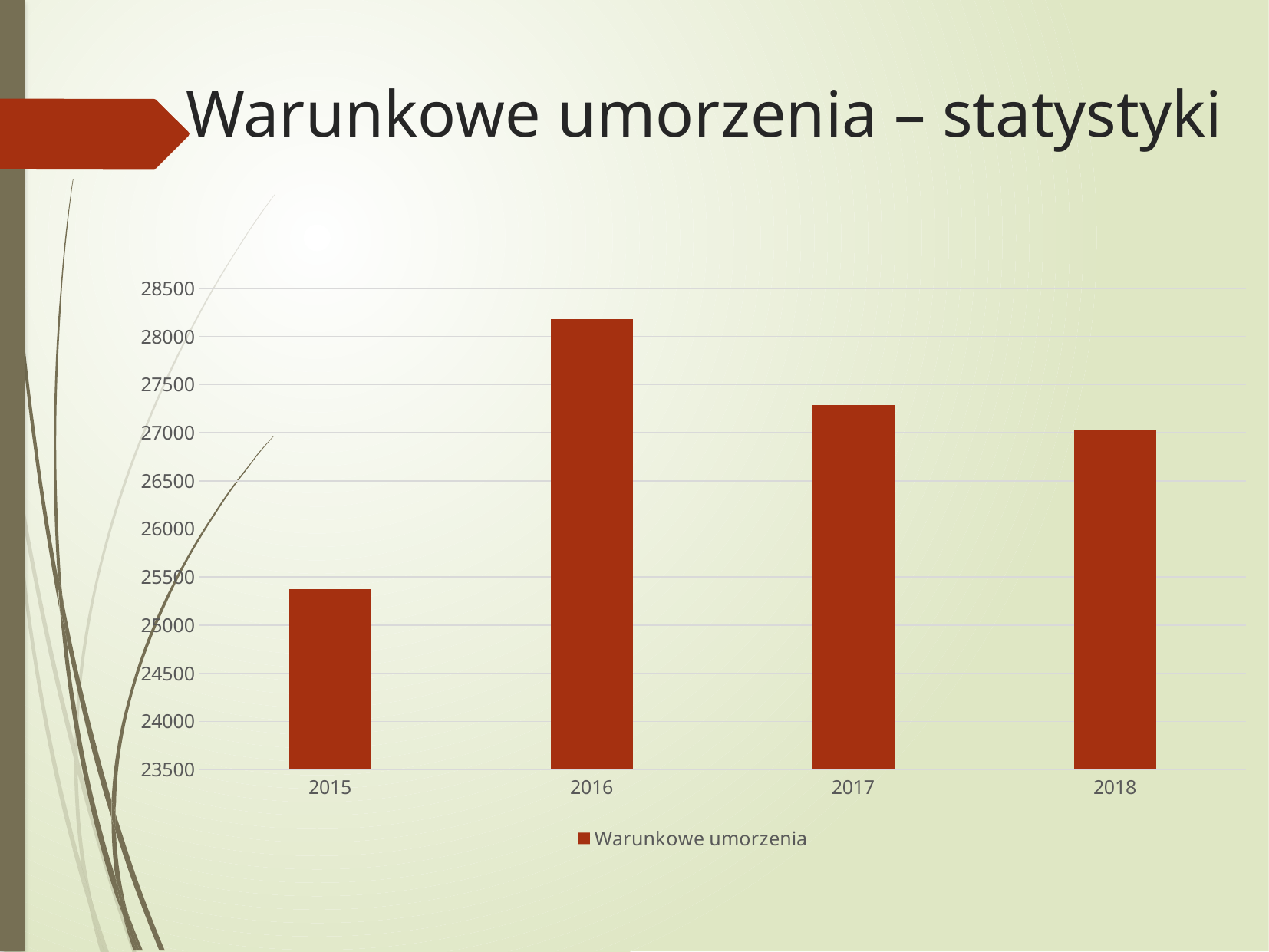
What kind of chart is shown on the slide? bar chart Is the value for 2015 greater or less than 26000? less Which year has the highest value in the chart? 2016 Which year has the lowest value in the chart? 2015 Which year has the larger value, 2017 or 2018? 2017 How many series does the chart's legend list? 1 Is the value for 2018 greater or less than 27500? less What is the name of the series shown in the chart's legend? Warunkowe umorzenia Is the value for 2017 greater or less than 27500? less How many years are shown on the x axis of the chart? 4 Do the values rise or fall from 2016 to 2018? fall